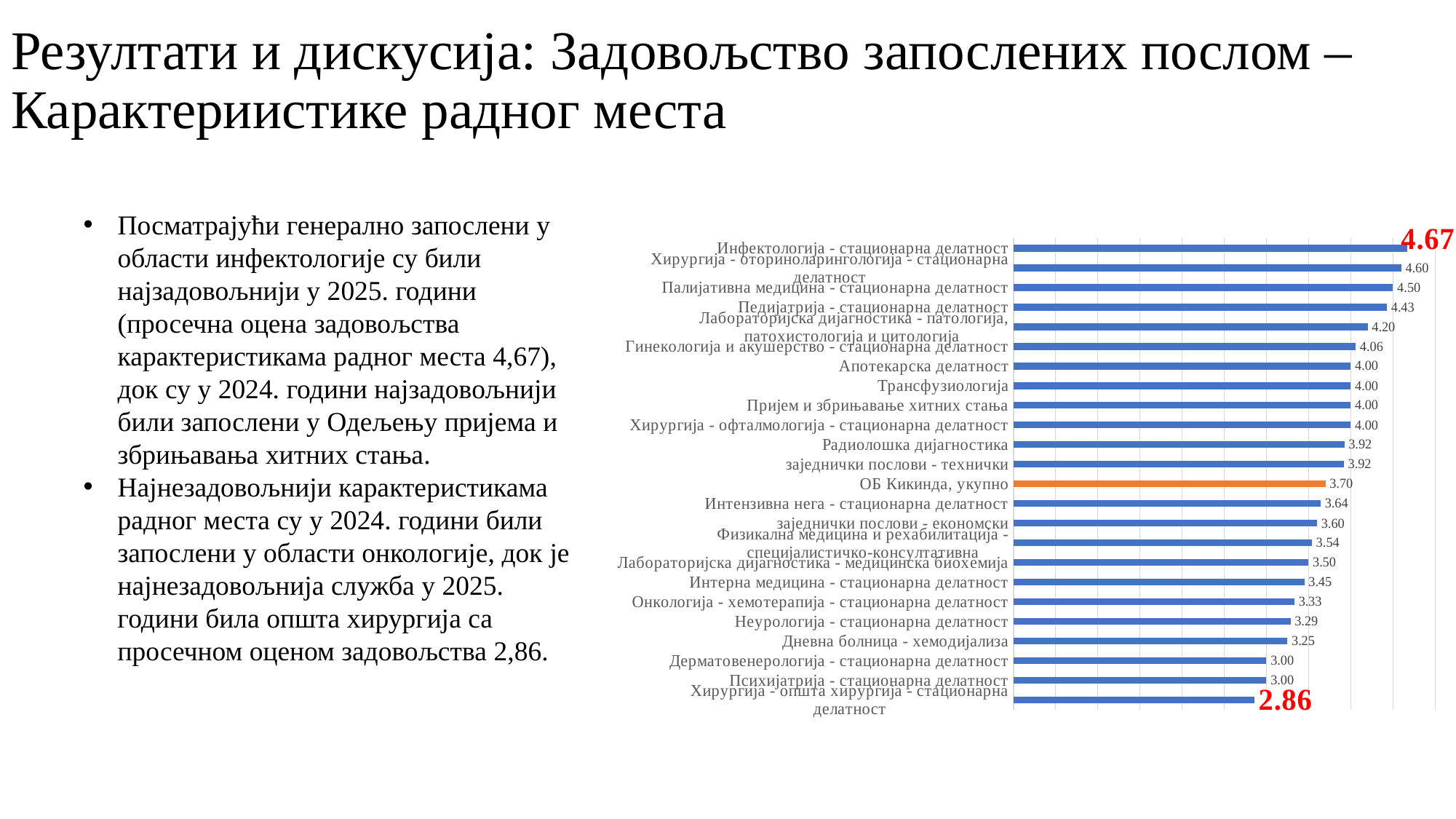
Which bar is shown in a different colour (orange) from the others? ОБ Кикинда, укупно Which category has the highest value? Инфектологија - стационарна делатност What is the value for ОБ Кикинда, укупно? 3.70 Which is larger: the value for Интензивна нега - стационарна делатност or the value for Неурологија - стационарна делатност? Интензивна нега - стационарна делатност How many categories are shown in the chart? 24 Which category has the lowest value? Хирургија - општа хирургија - стационарна делатност What is the value for Онкологија - хемотерапија - стационарна делатност? 3.33 What is the difference between the value for ОБ Кикинда, укупно and the value for Дневна болница - хемодијализа? 0.45 What kind of chart is shown on the slide? Bar chart What is the value for Инфектологија - стационарна делатност? 4.67 What is the difference between the value for Инфектологија - стационарна делатност and the value for Хирургија - општа хирургија - стационарна делатност? 1.81 What is the value for Педијатрија - стационарна делатност? 4.43